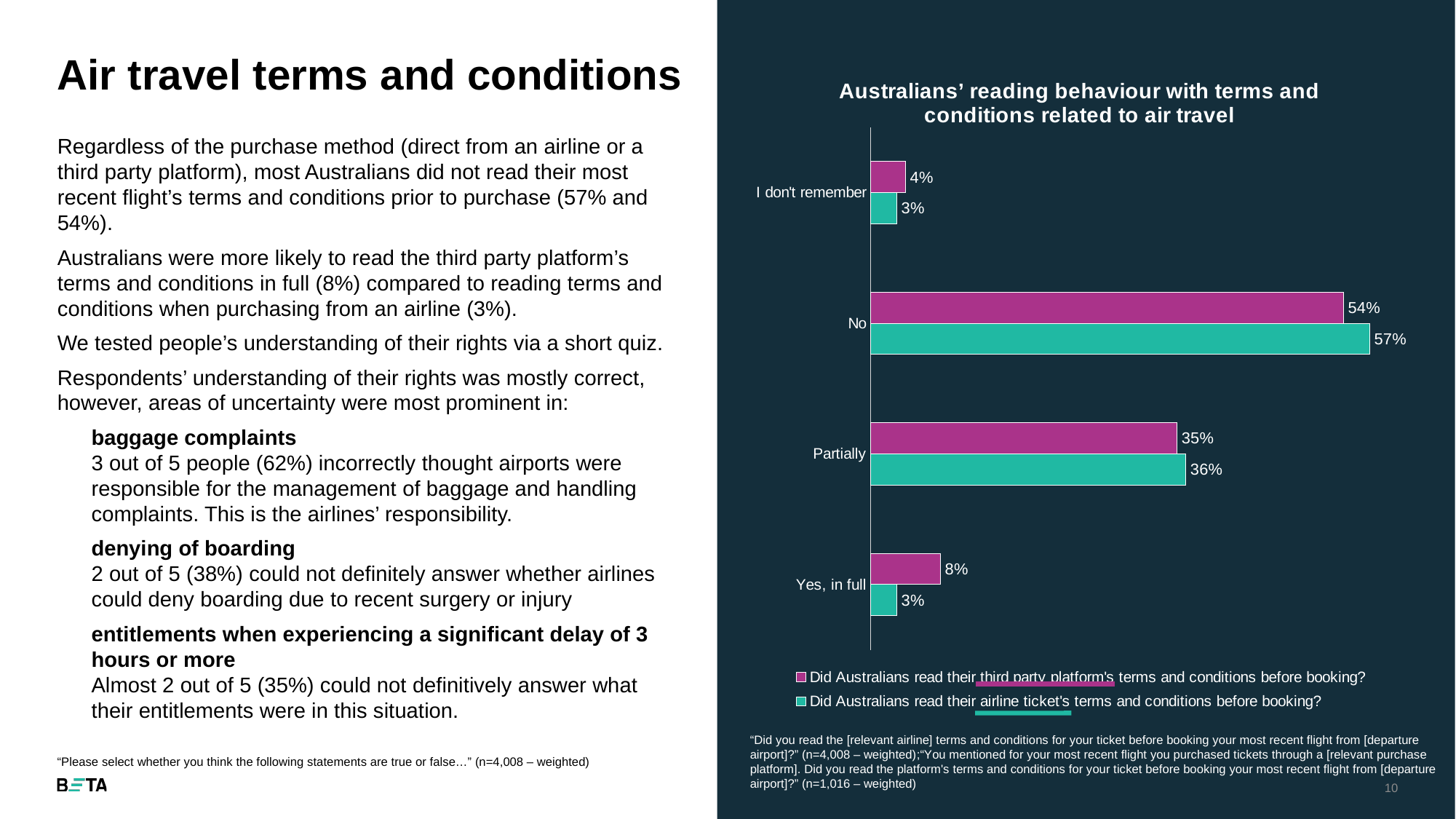
Which category has the highest value in the airline ticket's terms and conditions series? No What is the value for "Partially" in the third party platform's terms and conditions series? 35% What is the difference between the airline ticket's and third party platform's values for "No"? 3% How many categories are shown on the chart? 4 How many series does the legend list? 2 Which category has the lowest value in the third party platform's terms and conditions series? I don't remember What is the value for "I don't remember" in the airline ticket's terms and conditions series? 3% What is the value for "Yes, in full" in the third party platform's terms and conditions series? 8% What is the value for "No" in the airline ticket's terms and conditions series? 57% What kind of chart is shown on the slide? bar chart For "Yes, in full", which series has the larger value: third party platform's or airline ticket's? third party platform's What is the difference between the third party platform's and airline ticket's values for "Yes, in full"? 5%